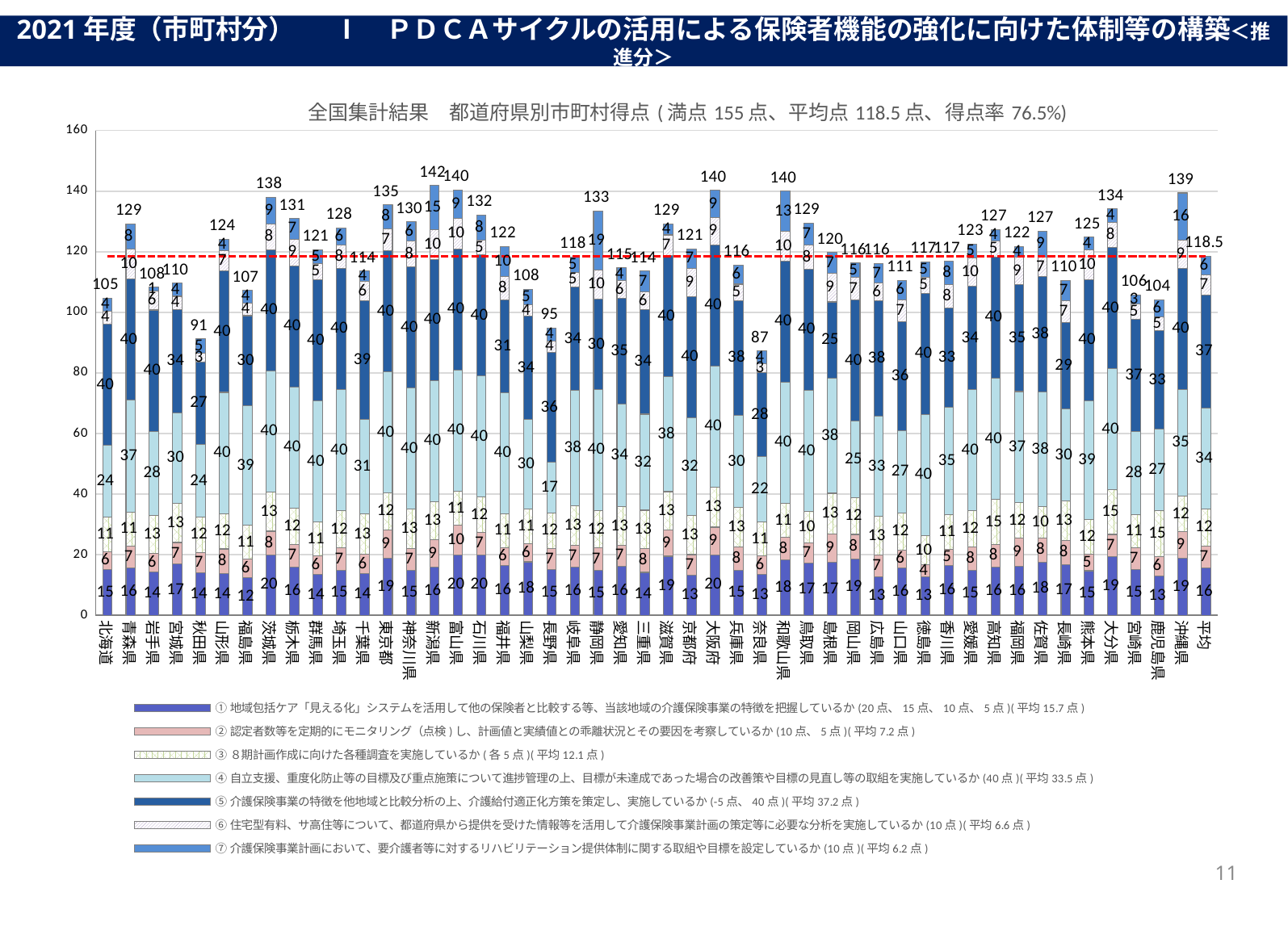
What kind of chart is shown on the slide? Stacked bar chart What is the difference between the total scores of 新潟県 and 奈良県? 55 What is the difference between the total scores of 大阪府 and 兵庫県? 24 What is the total score for 秋田県? 91 Is the total score for 奈良県 greater or less than 100? less What is the total score shown for 平均 (the average bar)? 118.5 Which has a higher total score, 茨城県 or 東京都? 茨城県 What value does the red dashed horizontal line represent? 118.5 (平均点) Which prefecture has the highest total score? 新潟県 (142) Which prefecture has the lowest total score? 奈良県 (87) How many series does the legend list? 7 What is the total score for 沖縄県? 139